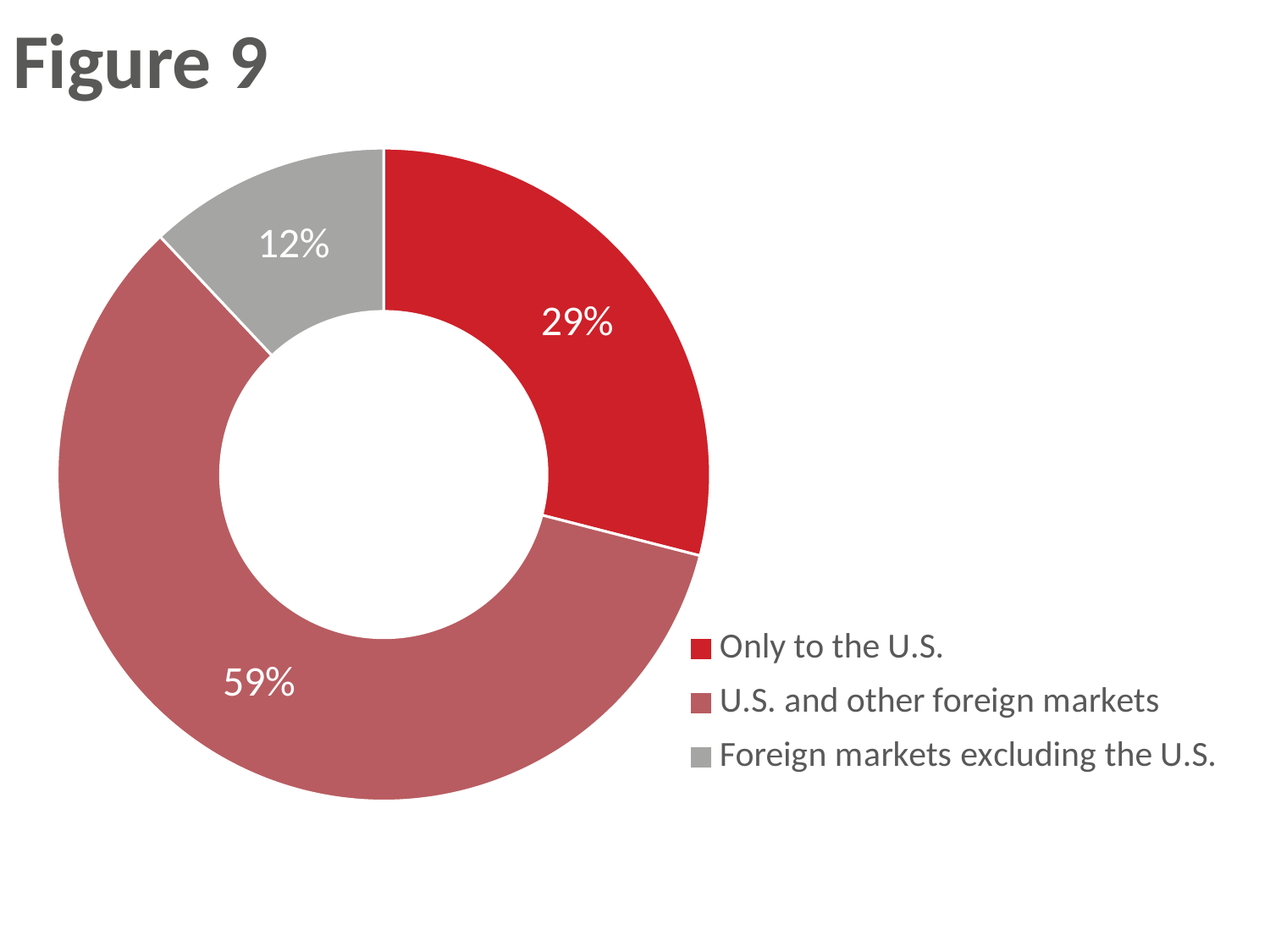
Which category has the smallest share of the chart? Foreign markets excluding the U.S. What percentage of the chart is labelled "Only to the U.S."? 29% What is the difference in percentage points between "Only to the U.S." and "Foreign markets excluding the U.S."? 17 What is the title shown above the chart? Figure 9 Which category has the largest share of the chart? U.S. and other foreign markets Which is larger: the share for "Only to the U.S." or the share for "Foreign markets excluding the U.S."? Only to the U.S. How many categories are shown in the chart? 3 What percentage of the chart is labelled "Foreign markets excluding the U.S."? 12% What percentage of the chart is labelled "U.S. and other foreign markets"? 59% What is the difference in percentage points between "U.S. and other foreign markets" and "Only to the U.S."? 30 What kind of chart is shown on the slide? Doughnut (pie) chart What colour is the segment for "Foreign markets excluding the U.S."? Grey